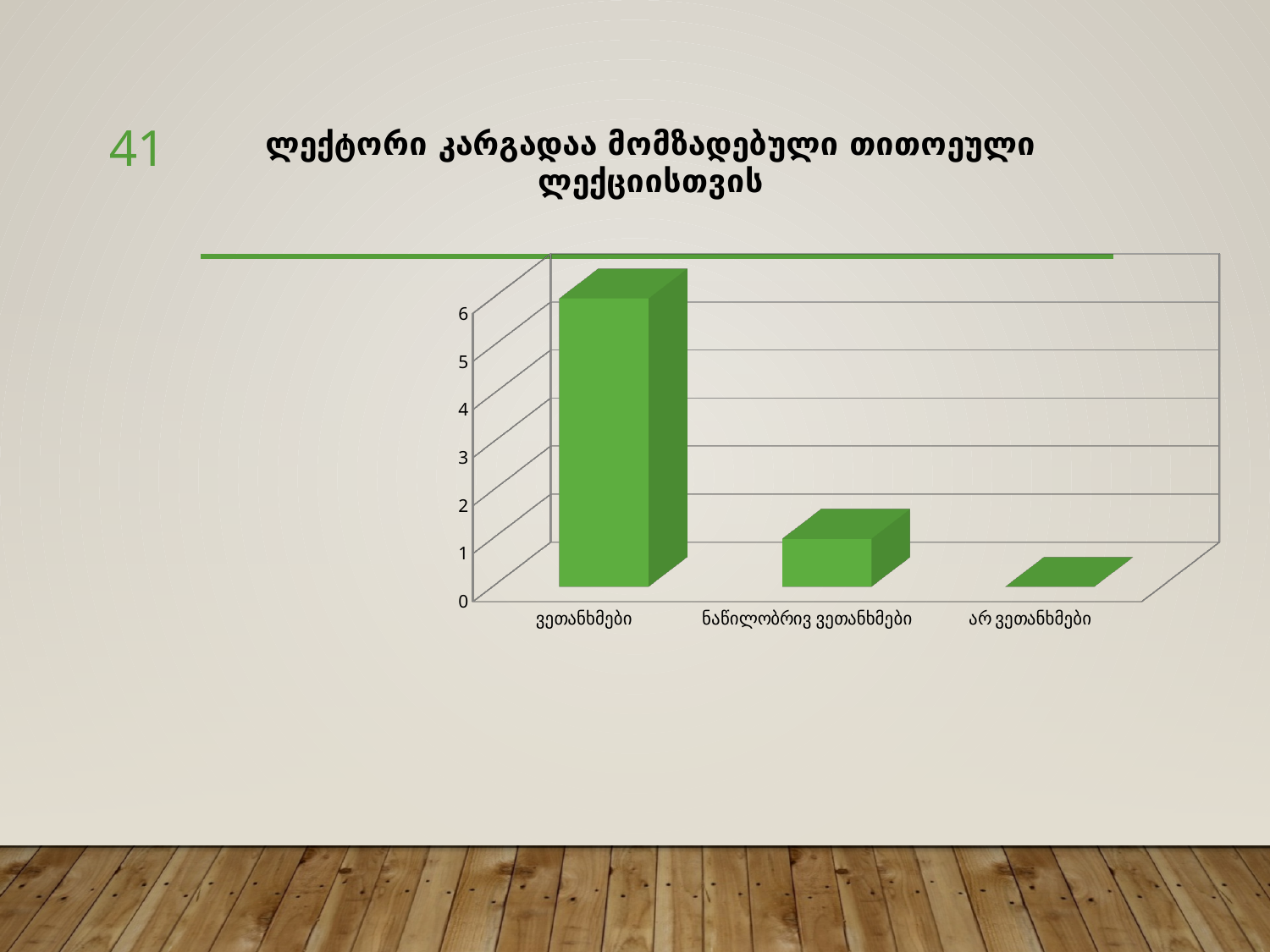
Which is larger, the value for ვეთანხმები or the value for ნაწილობრივ ვეთანხმები? ვეთანხმები Do the values rise or fall moving from left to right along the x axis? fall Which category has the lowest value in the chart? არ ვეთანხმები What kind of chart is shown on the slide? bar chart How many categories are shown on the x axis of the chart? 3 Is the value for ნაწილობრივ ვეთანხმები greater or less than 3? less Which is larger, the value for ნაწილობრივ ვეთანხმები or the value for არ ვეთანხმები? ნაწილობრივ ვეთანხმები Which category has the highest value in the chart? ვეთანხმები Is the value for ვეთანხმები greater or less than 5? greater What is the highest value shown on the vertical axis of the chart? 6 What is the title of the chart on the slide? ლექტორი კარგადაა მომზადებული თითოეული ლექციისთვის Is the value for არ ვეთანხმები greater or less than 1? less